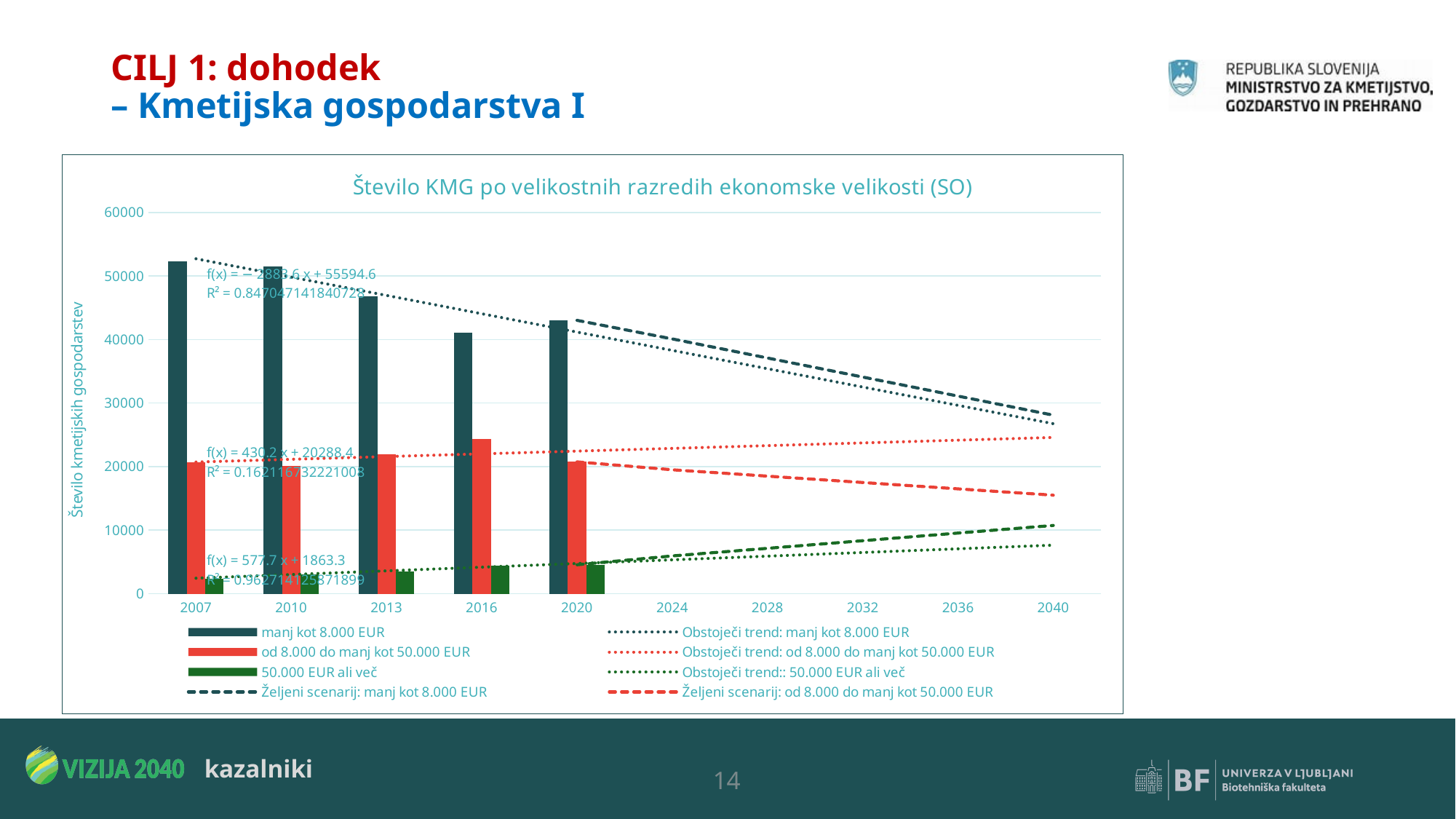
What kind of chart is used to show the number of farms per year? bar chart For how many years are bars plotted in the chart? 5 How many entries does the legend list? 8 Is the value for 'manj kot 8.000 EUR' in 2007 greater or less than 50000? greater Is the value for 'manj kot 8.000 EUR' in 2020 greater or less than 50000? less What is the title of the chart? Število KMG po velikostnih razredih ekonomske velikosti (SO) In which year is the bar for 'manj kot 8.000 EUR' the lowest? 2016 Is the value for '50.000 EUR ali več' in 2020 greater or less than 10000? less In which year is the bar for 'od 8.000 do manj kot 50.000 EUR' the highest? 2016 In 2020, which is larger: the bar for 'manj kot 8.000 EUR' or the bar for 'od 8.000 do manj kot 50.000 EUR'? manj kot 8.000 EUR In which year is the bar for 'manj kot 8.000 EUR' the highest? 2007 Do the bars for 'manj kot 8.000 EUR' generally rise or fall from 2007 to 2020? fall